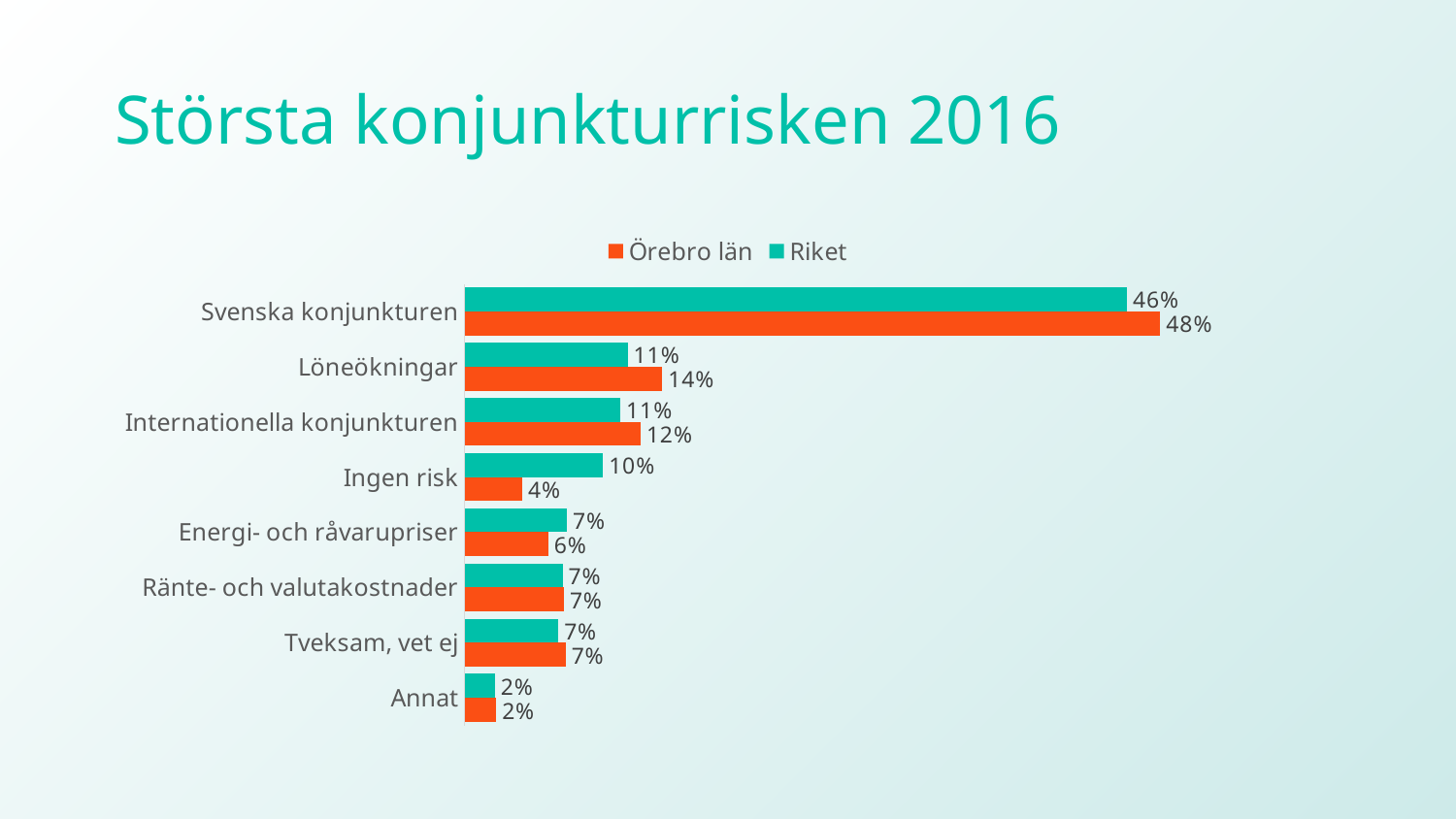
What is the value for Örebro län for Svenska konjunkturen? 48% What is the value for Riket for Ingen risk? 10% What kind of chart is shown on the slide? Bar chart What is the value for Örebro län for Löneökningar? 14% What is the difference between Örebro län and Riket for Ingen risk? 6% Which category has the highest value for Riket? Svenska konjunkturen How many categories are shown in the chart? 8 Which is larger for Löneökningar, Örebro län or Riket? Örebro län Which category has the lowest value for Örebro län? Annat What is the title of the slide? Största konjunkturrisken 2016 What is the difference between Örebro län and Riket for Svenska konjunkturen? 2% How many series does the legend list? 2